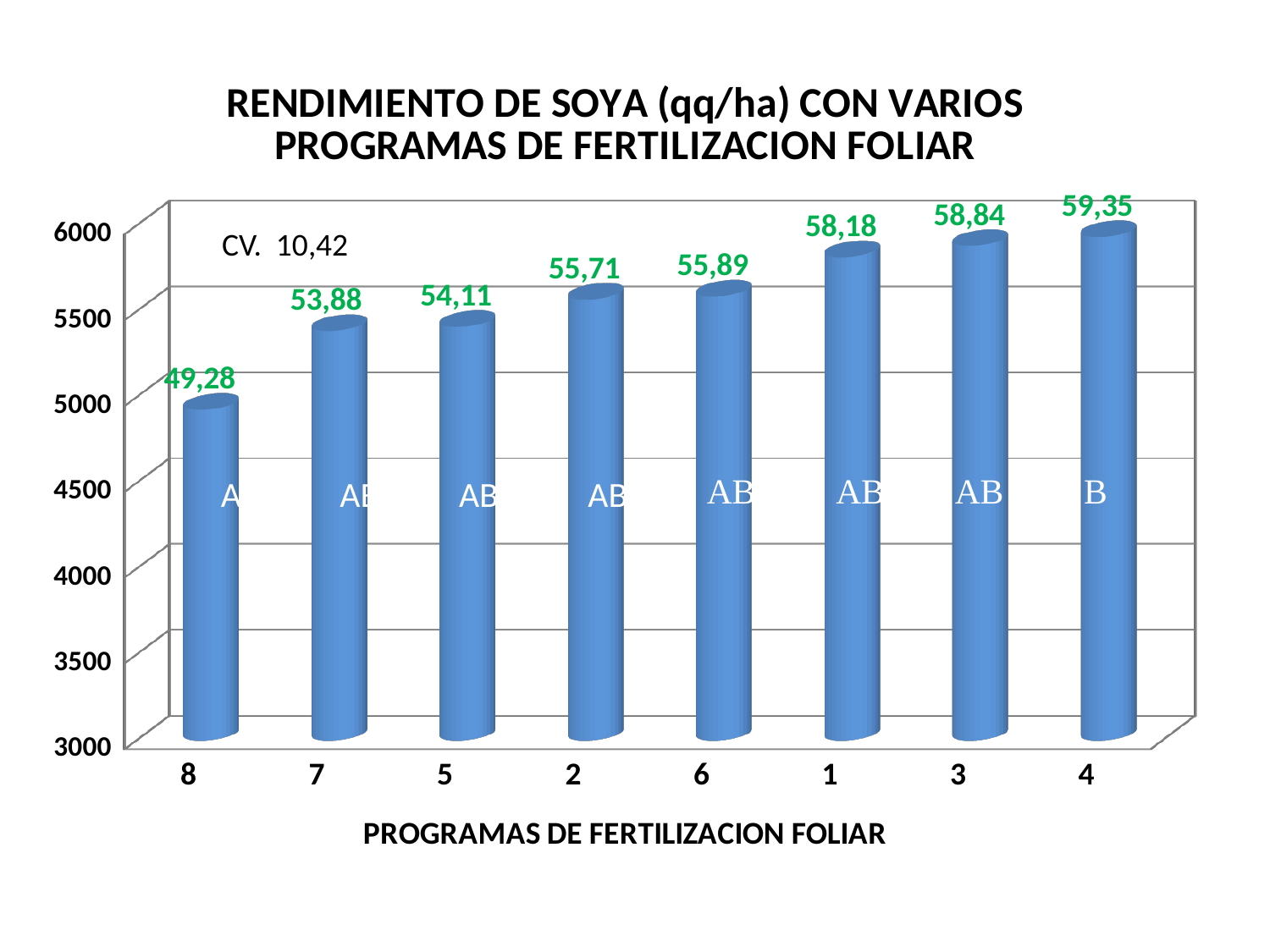
Which program has the highest bar? 4 What kind of chart is shown on the slide? bar chart How many programs (bars) are shown on the chart? 8 What is the data label shown for program 8? 49,28 Is the bar for program 2 greater or less than 5500 on the axis? greater Is the bar for program 8 greater or less than 5000 on the axis? less What is the difference between the data labels for program 4 and program 8? 10,07 What is the x-axis title of the chart? PROGRAMAS DE FERTILIZACION FOLIAR Which has a larger value, program 7 or program 6? 6 Which program has the lowest bar? 8 What is the data label shown for program 2? 55,71 What is the data label shown for program 1? 58,18